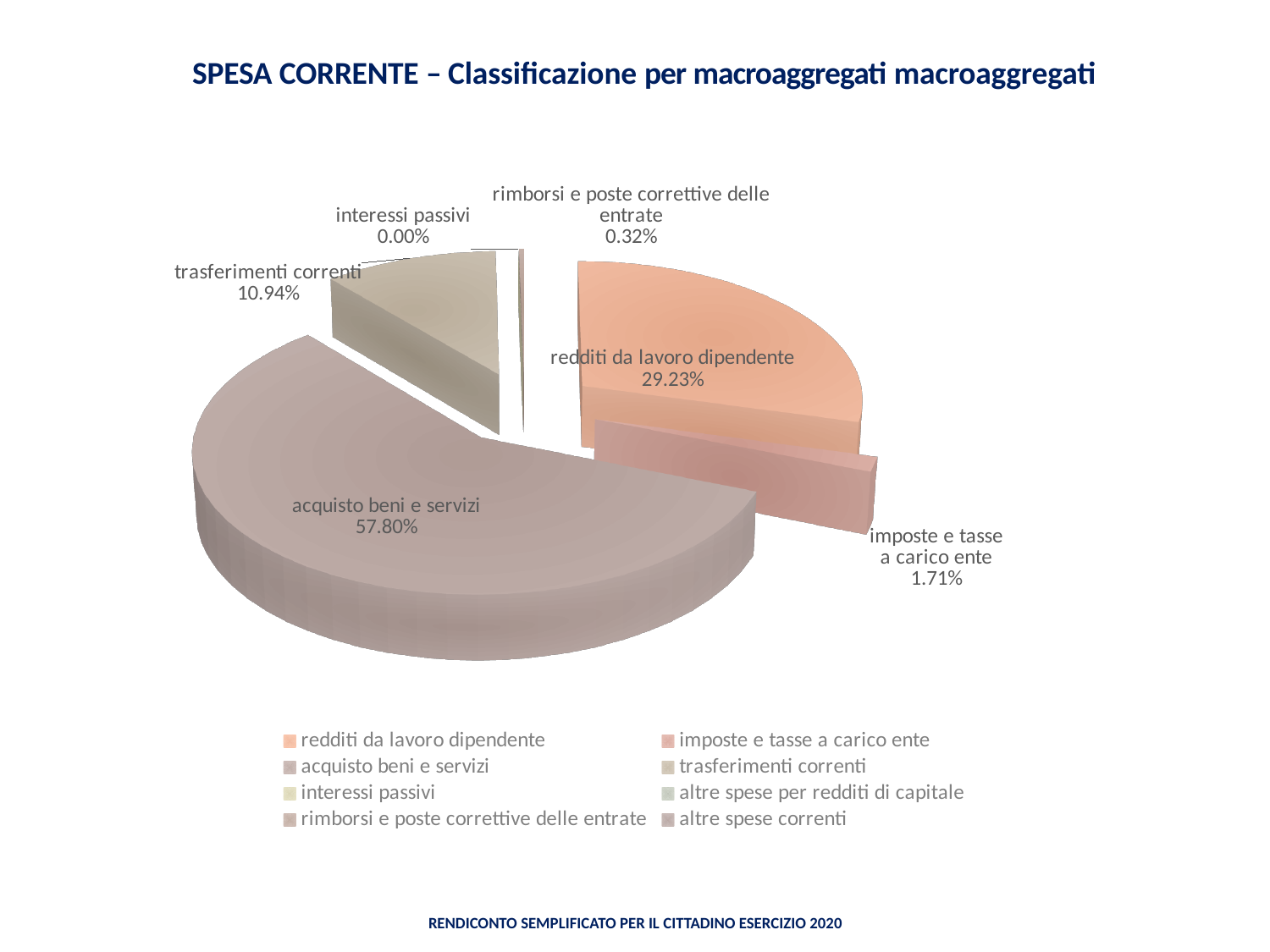
What is the difference in percentage points between 'acquisto beni e servizi' and 'redditi da lavoro dipendente'? 28.57 What share of the pie does 'acquisto beni e servizi' represent? 57.80% Which category has the largest share of the pie? acquisto beni e servizi How many entries does the legend list? 8 What percentage is shown for 'imposte e tasse a carico ente'? 1.71% What value is labelled for 'interessi passivi'? 0.00% Which labelled category has the smallest share of the pie? interessi passivi What percentage is shown for 'rimborsi e poste correttive delle entrate'? 0.32% What value is labelled for 'trasferimenti correnti'? 10.94% Which is larger, 'trasferimenti correnti' or 'imposte e tasse a carico ente'? trasferimenti correnti What percentage is shown for 'redditi da lavoro dipendente'? 29.23% What kind of chart is shown on the slide? pie chart